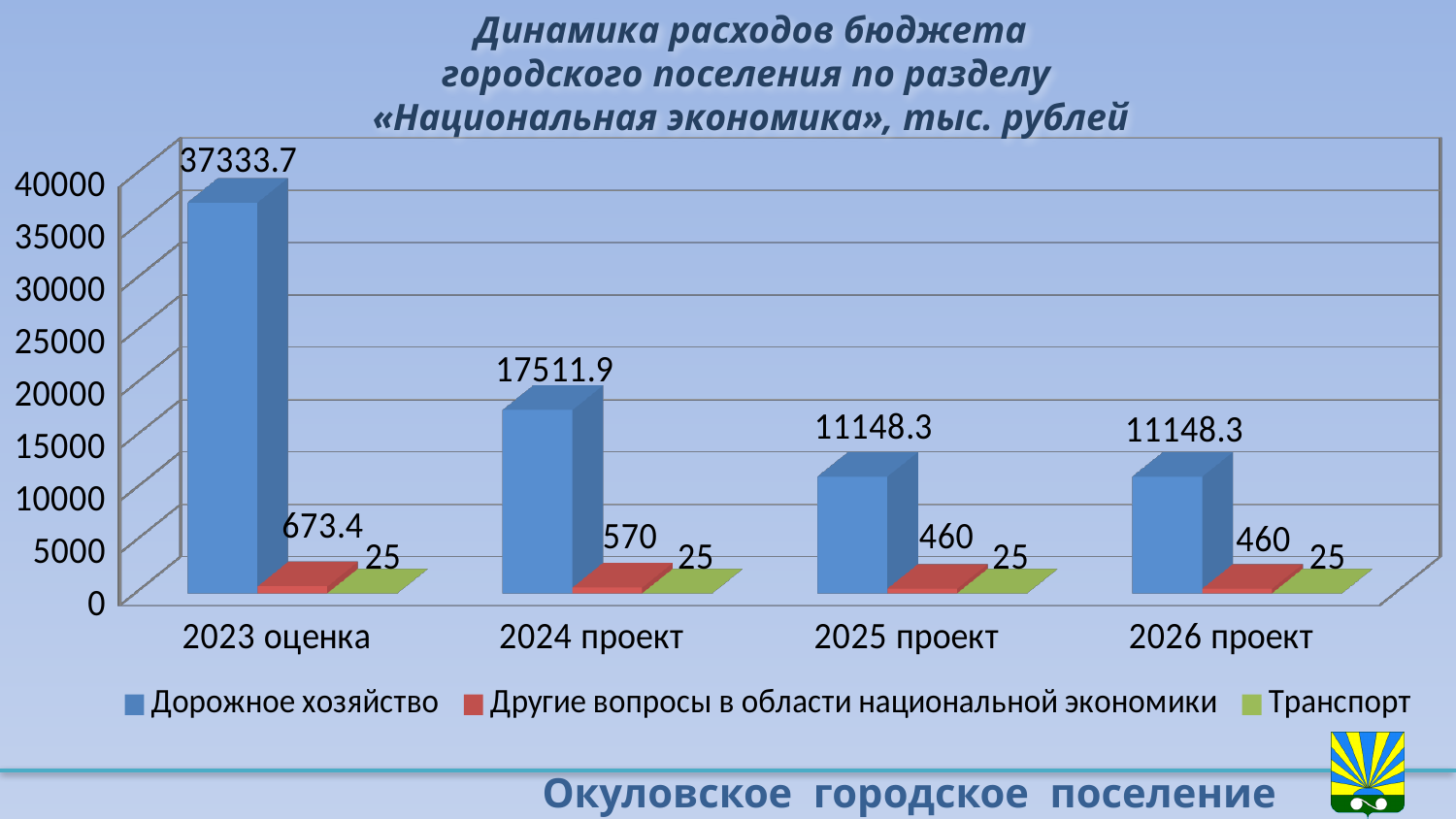
What is the difference between Дорожное хозяйство in 2023 оценка and 2024 проект? 19821.8 What kind of chart is shown? bar chart Which series has the lowest value in 2024 проект? Транспорт What is the value for Другие вопросы в области национальной экономики in 2024 проект? 570 Which is larger: Другие вопросы в области национальной экономики in 2023 оценка or in 2025 проект? 2023 оценка In which category is Дорожное хозяйство highest? 2023 оценка Is the value for Дорожное хозяйство in 2024 проект greater or less than 15000? greater What is the value for Дорожное хозяйство in 2023 оценка? 37333.7 How many categories are shown on the x axis? 4 What is the value for Транспорт in 2025 проект? 25 How many series does the legend list? 3 What is the value for Дорожное хозяйство in 2026 проект? 11148.3